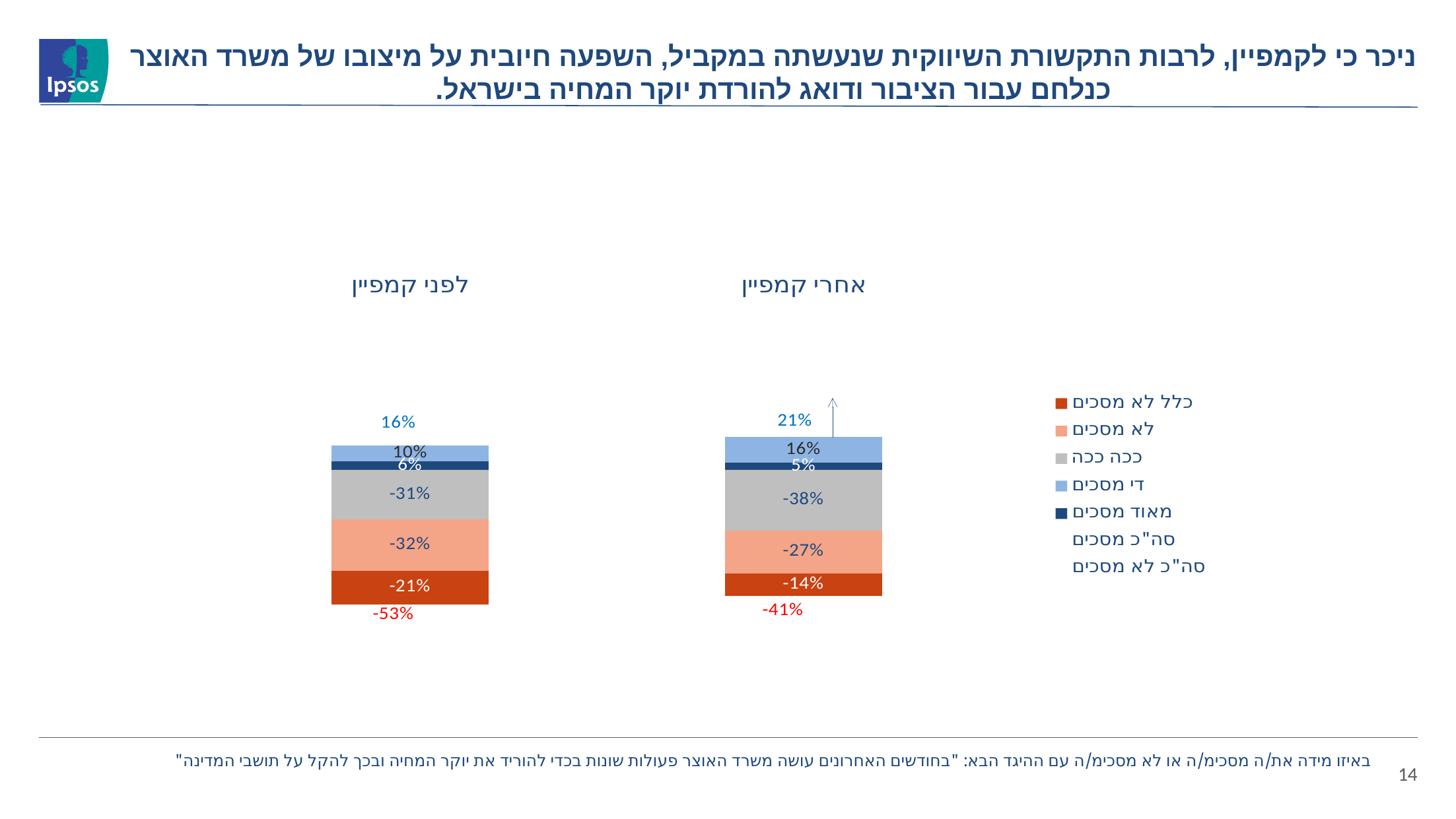
How many bars (categories) are plotted in the chart? 2 What is the value of the די מסכים segment for אחרי קמפיין? 16% What is the value of the ככה ככה segment for אחרי קמפיין? -38% What is the difference between the סה"כ מסכים values for אחרי קמפיין (21%) and לפני קמפיין (16%)? 5% How many entries does the legend list? 7 What kind of chart is shown on the slide? Stacked bar chart What is the סה"כ לא מסכים value shown below the אחרי קמפיין bar? -41% What is the difference between the לא מסכים values for לפני קמפיין (-32%) and אחרי קמפיין (-27%)? 5% Which colour represents the כלל לא מסכים segment in the legend? Dark orange-red Which bar has the higher סה"כ מסכים value, לפני קמפיין or אחרי קמפיין? אחרי קמפיין What is the סה"כ מסכים value shown above the לפני קמפיין bar? 16% What is the value of the כלל לא מסכים segment for לפני קמפיין? -21%